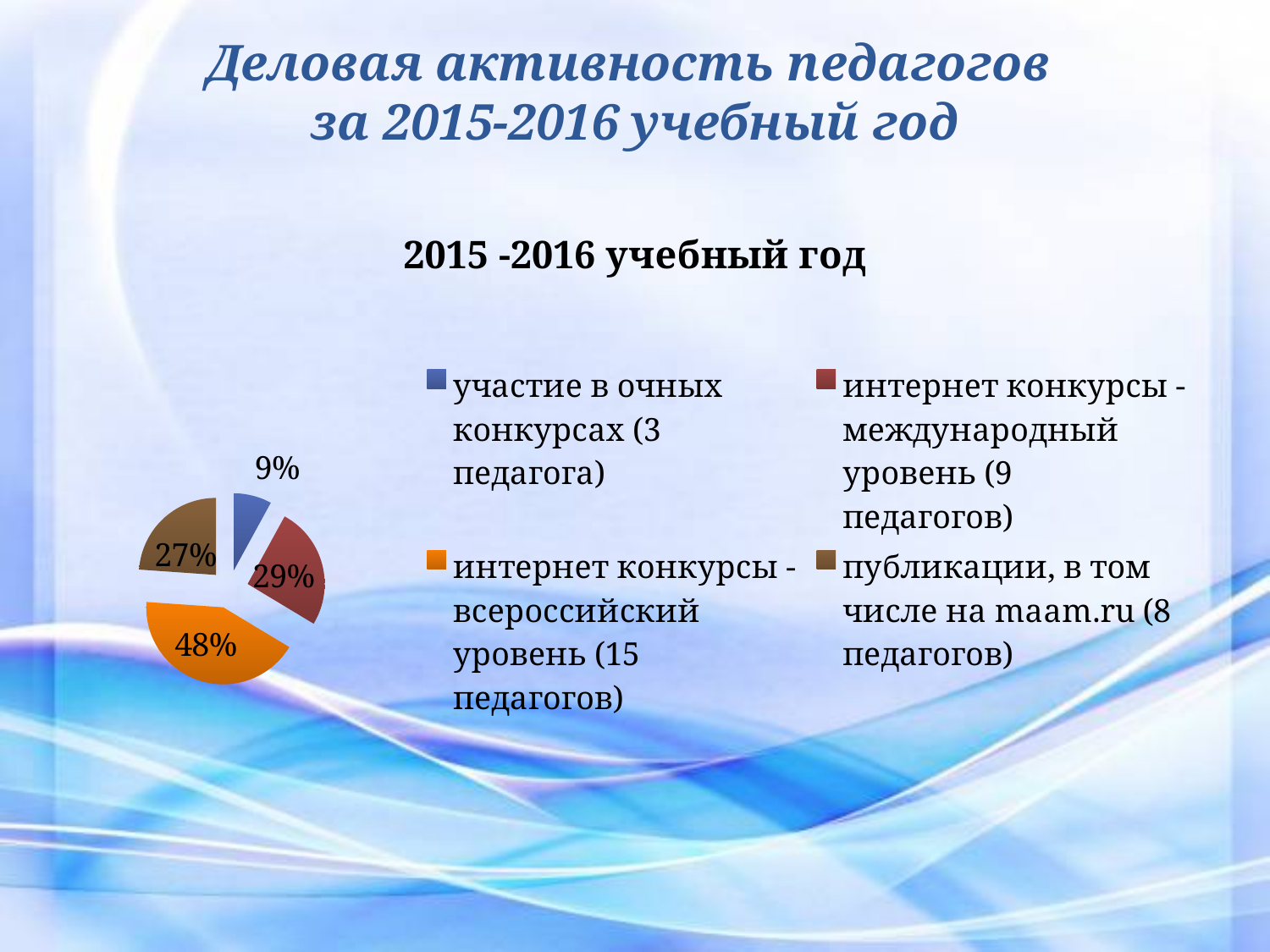
Which is larger: the share for 'интернет конкурсы - международный уровень' or the share for 'публикации, в том числе на maam.ru'? интернет конкурсы - международный уровень Which category has the largest share of the pie? интернет конкурсы - всероссийский уровень (15 педагогов) What is the chart's title? 2015 -2016 учебный год How many slices does the pie chart have? 4 Which category has the smallest share of the pie? участие в очных конкурсах (3 педагога) What share of the pie is 'интернет конкурсы - всероссийский уровень (15 педагогов)'? 48% What share of the pie is 'публикации, в том числе на maam.ru (8 педагогов)'? 27% What kind of chart is shown on the slide? pie chart What share of the pie is 'интернет конкурсы - международный уровень (9 педагогов)'? 29% What is the difference in percentage points between the 48% slice and the 27% slice? 21 What colour is the slice for 'интернет конкурсы - всероссийский уровень (15 педагогов)'? orange